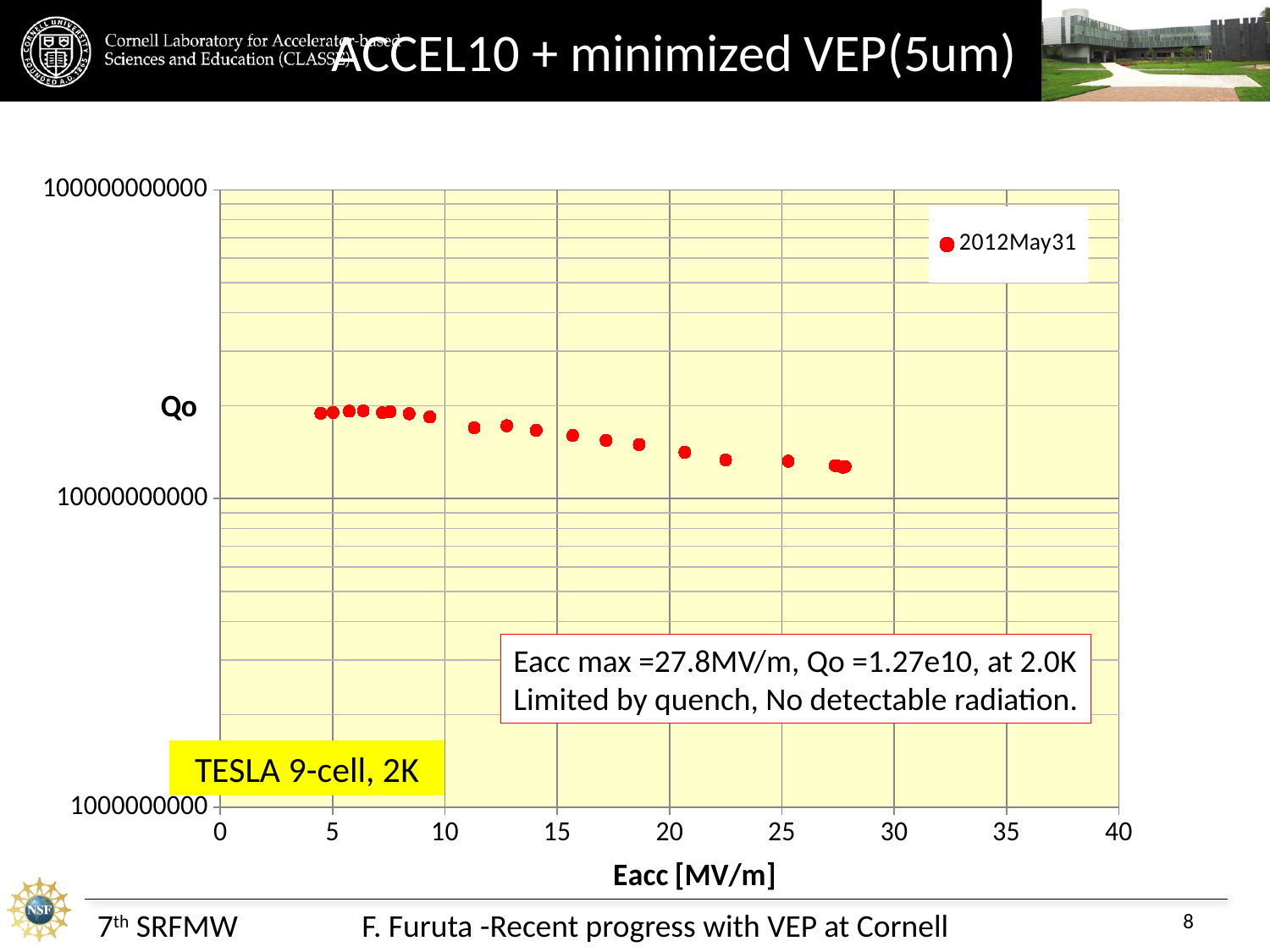
What is the maximum value shown on the x axis of the chart? 40 Is the Qo value at the highest Eacc point greater or less than 1000000000? greater According to the annotation on the chart, what is the maximum Eacc reached? 27.8MV/m How many series does the chart legend list? 1 What is the title of the x axis of the chart? Eacc [MV/m] What is the name of the series shown in the chart legend? 2012May31 According to the annotation on the chart, what is Qo at the maximum Eacc? 1.27e10 Is the Qo value at Eacc of about 5 MV/m greater or less than 10000000000? greater Does Qo rise or fall as Eacc increases along the x axis? fall Which has the higher Qo: the data point near Eacc 5 MV/m or the data point near Eacc 25 MV/m? the point near 5 MV/m What kind of chart is shown on the slide? scatter chart Is the Qo value at Eacc of about 25 MV/m greater or less than 100000000000? less